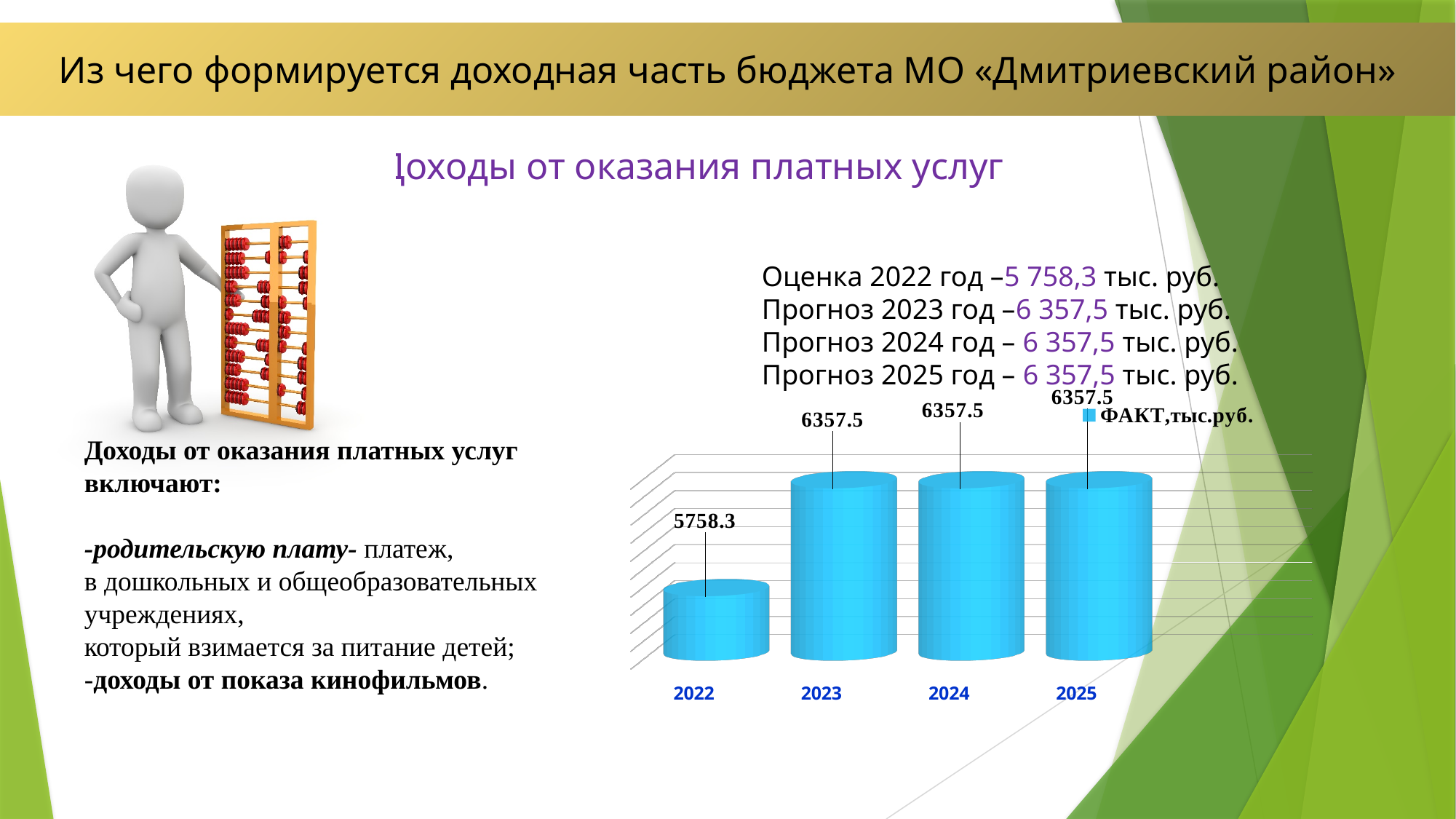
What is the value for 2023 in the chart? 6357.5 What colour are the bars in the chart? Blue What is the difference between the values for 2023 and 2022? 599.2 Which year has the lowest value in the chart? 2022 What is the value for 2025 in the chart? 6357.5 Do the values rise or fall from 2022 to 2023? Rise How many series does the chart legend list? 1 How many years are shown on the x axis of the chart? 4 What is the legend entry of the chart? ФАКТ,тыс.руб. What is the value for 2022 in the chart? 5758.3 What kind of chart is shown on the slide? Bar chart Which is larger, the value for 2022 or the value for 2024? 2024